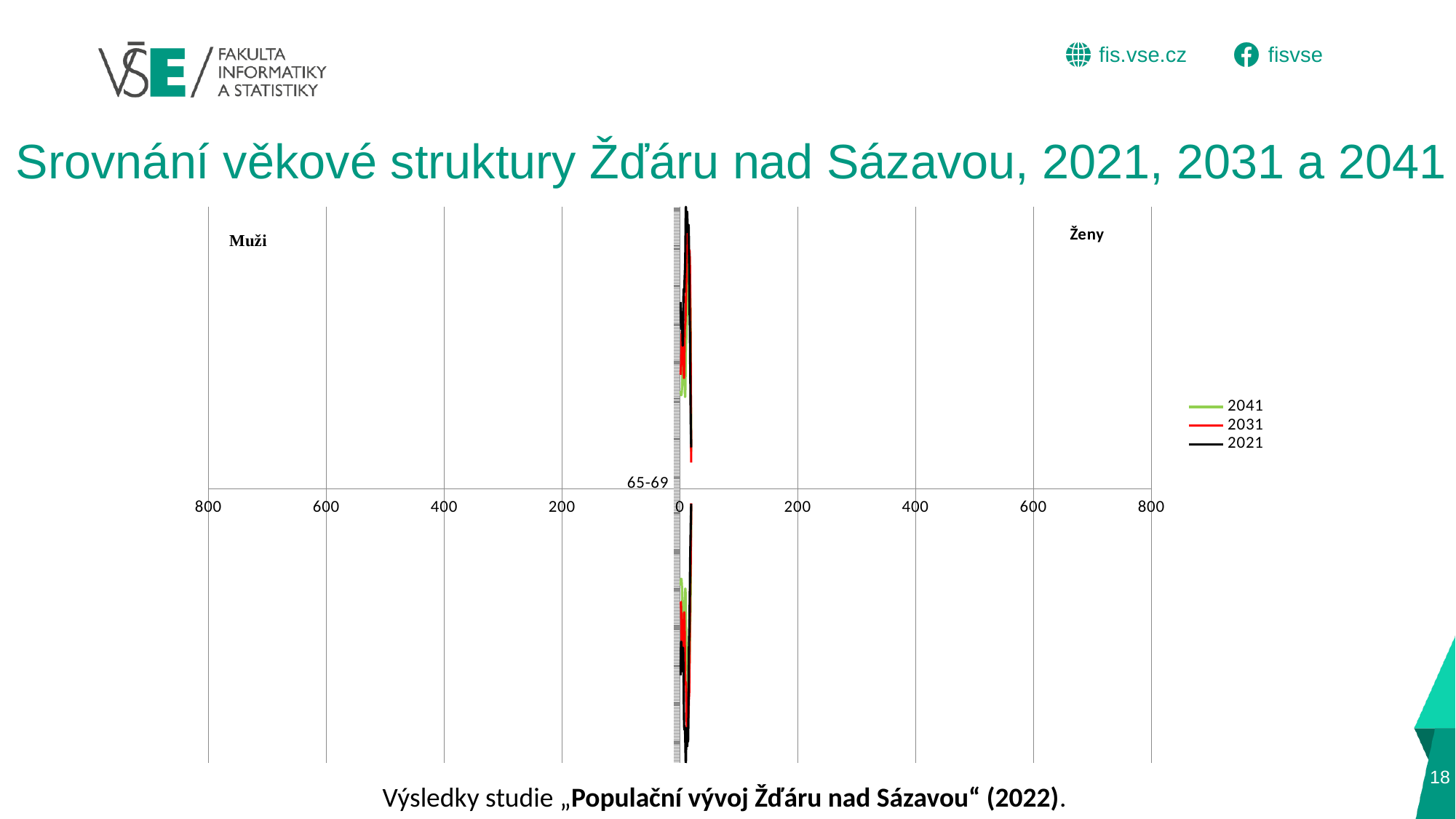
Is the value for the 65-69 age group in the 2031 series greater or less than 200? less What labels mark the left and right halves of the chart? Muži (left) and Ženy (right) Which years are listed in the chart legend? 2041, 2031, 2021 Is the value for the 65-69 age group in the 2021 series greater or less than 200? less What kind of chart is shown on the slide? line chart Is the value for the 65-69 age group in the 2041 series greater or less than 200? less How many series does the chart legend list? 3